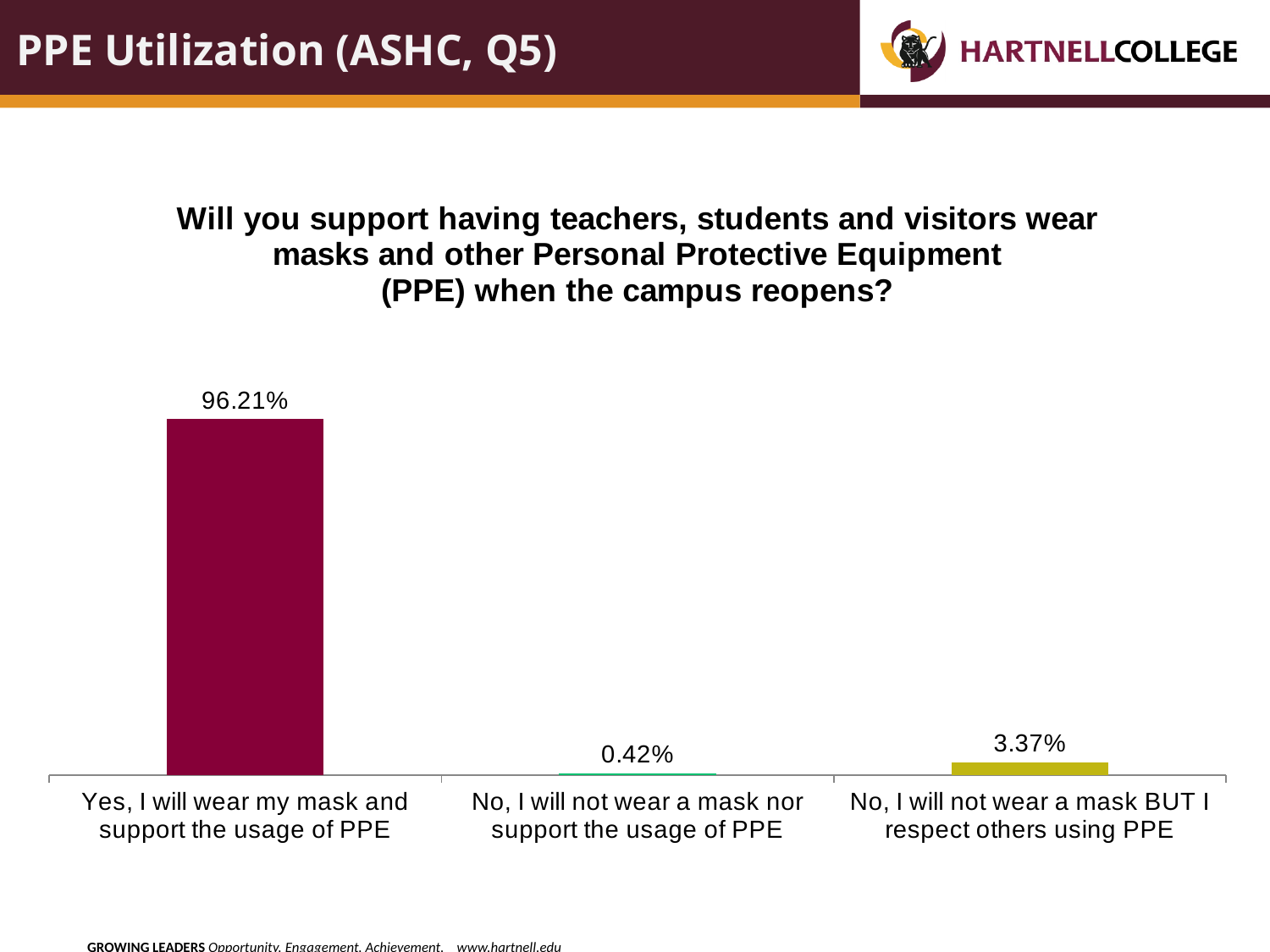
What percentage of respondents chose "No, I will not wear a mask nor support the usage of PPE"? 0.42% How many response categories are shown in the chart? 3 What colour is the bar for "Yes, I will wear my mask and support the usage of PPE"? Maroon Which is larger: the percentage for "No, I will not wear a mask BUT I respect others using PPE" or for "No, I will not wear a mask nor support the usage of PPE"? No, I will not wear a mask BUT I respect others using PPE What percentage of respondents chose "No, I will not wear a mask BUT I respect others using PPE"? 3.37% What is the difference in percentage points between "No, I will not wear a mask BUT I respect others using PPE" and "No, I will not wear a mask nor support the usage of PPE"? 2.95 What is the difference in percentage points between "Yes, I will wear my mask and support the usage of PPE" and "No, I will not wear a mask BUT I respect others using PPE"? 92.84 Which response category has the lowest percentage? No, I will not wear a mask nor support the usage of PPE What kind of chart is shown on the slide? Bar chart What percentage of respondents chose "Yes, I will wear my mask and support the usage of PPE"? 96.21% What survey question is shown as the chart title? Will you support having teachers, students and visitors wear masks and other Personal Protective Equipment (PPE) when the campus reopens? Which response category has the highest percentage? Yes, I will wear my mask and support the usage of PPE